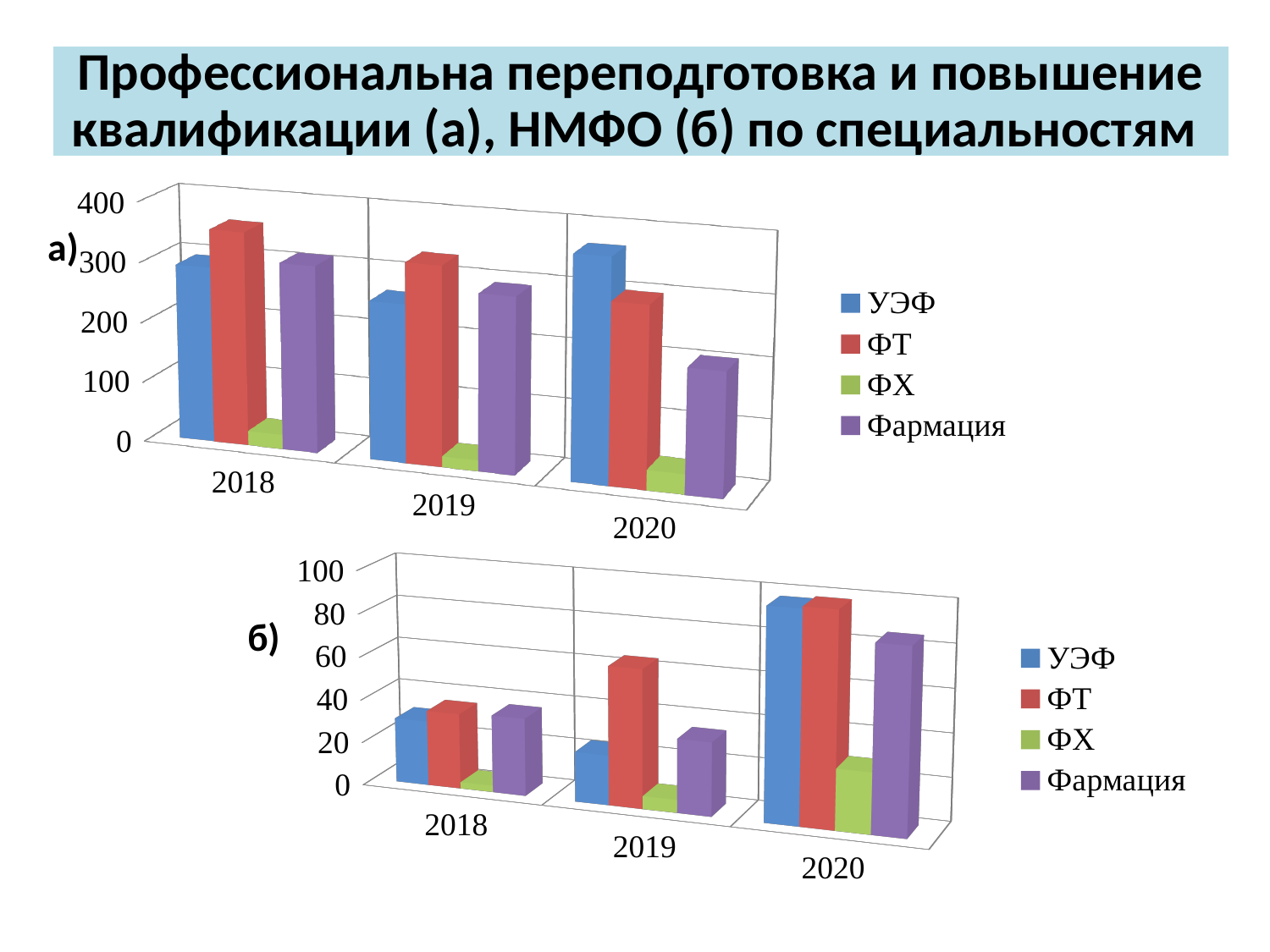
In chart б), which series has the highest value in 2019? ФТ How many series does the legend of chart б) list? 4 What kind of chart is chart a) at the top of the slide? bar chart What colour represents the ФХ series in the legends of both charts? green In chart б), does the value for Фармация rise or fall from 2019 to 2020? rise In chart a), which is larger in 2020: УЭФ or Фармация? УЭФ In chart a), which series has the lowest value in 2020? ФХ How many year categories are shown on the x axis of chart a)? 3 In chart a), is the value for ФТ in 2018 greater or less than 300? greater In chart a), which series has the highest value in 2018? ФТ In chart б), is the value for УЭФ in 2020 greater or less than 60? greater